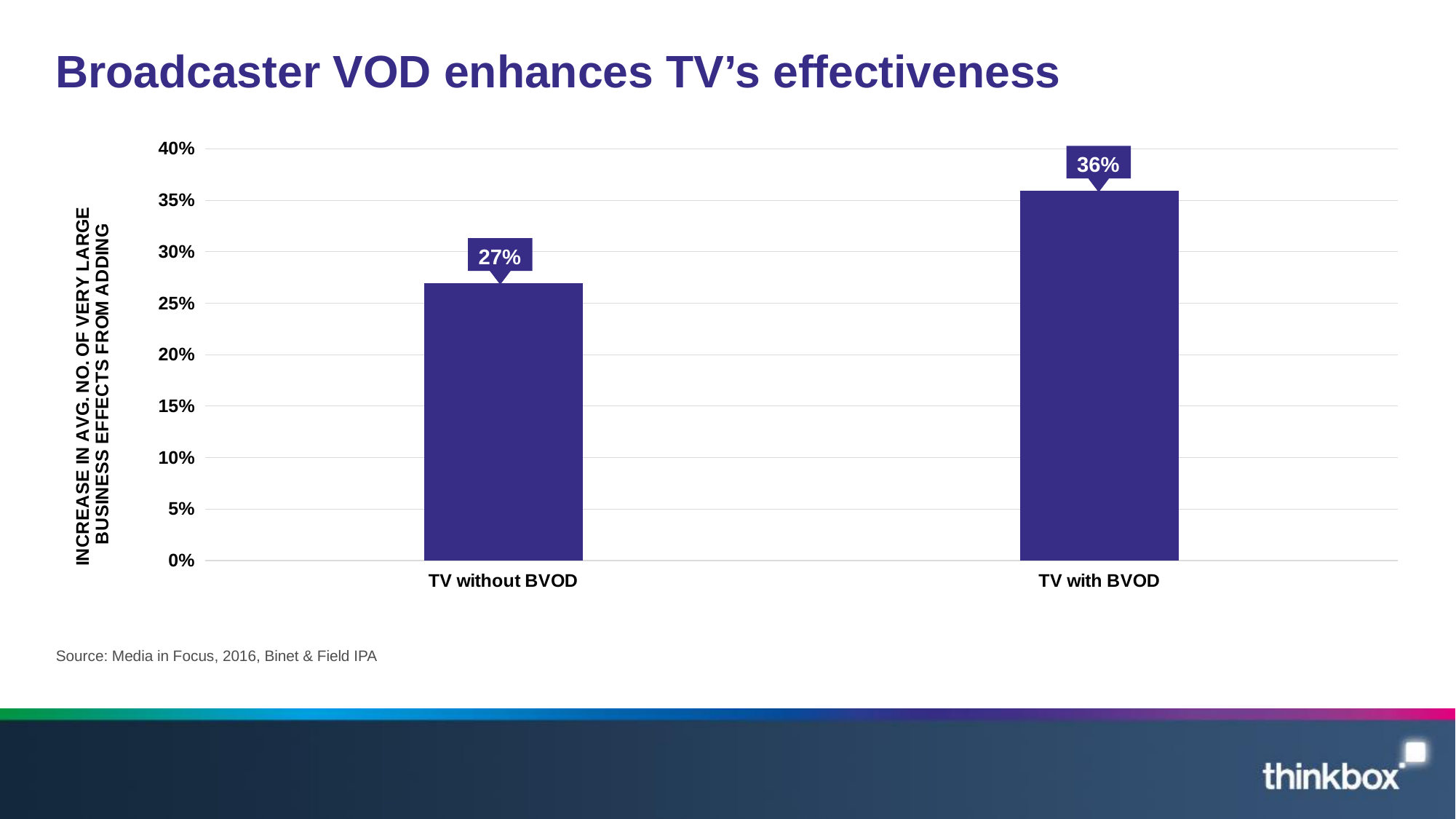
What is the value for TV with BVOD? 36% How many categories are shown on the chart? 2 What is the value for TV without BVOD? 27% Is the value for TV with BVOD greater or less than 35%? greater What is the difference between the values for TV with BVOD and TV without BVOD? 9% Is the value for TV without BVOD greater or less than 30%? less Which category has the highest value? TV with BVOD What is the title of the slide? Broadcaster VOD enhances TV's effectiveness Which is larger, the value for TV with BVOD or TV without BVOD? TV with BVOD Which category has the lowest value? TV without BVOD What is the maximum value shown on the y axis? 40% What kind of chart is shown on the slide? Bar chart